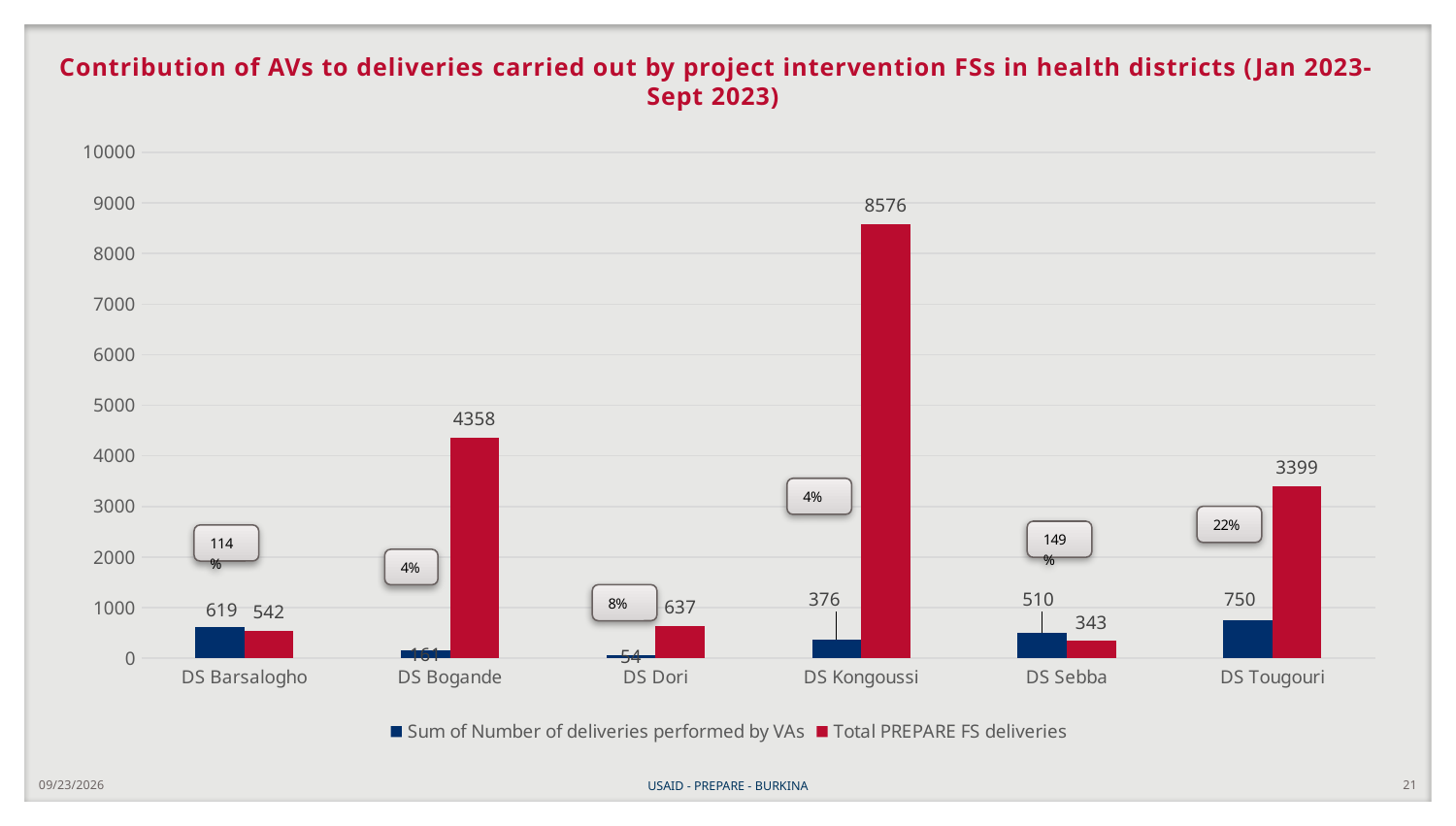
What kind of chart is shown on the slide? Bar chart What is the value of Total PREPARE FS deliveries for DS Bogande? 4358 For DS Barsalogho, which is larger: deliveries performed by VAs or Total PREPARE FS deliveries? Deliveries performed by VAs What is the value of Total PREPARE FS deliveries for DS Kongoussi? 8576 Is the Total PREPARE FS deliveries value for DS Kongoussi greater or less than 8000? greater Which health district has the highest Total PREPARE FS deliveries? DS Kongoussi What is the difference between Total PREPARE FS deliveries and deliveries performed by VAs for DS Tougouri? 2649 What is the Sum of Number of deliveries performed by VAs for DS Tougouri? 750 What percentage is shown in the callout above DS Tougouri? 22% How many health districts are shown on the x axis? 6 How many series does the legend list? 2 Which health district has the lowest Total PREPARE FS deliveries? DS Sebba